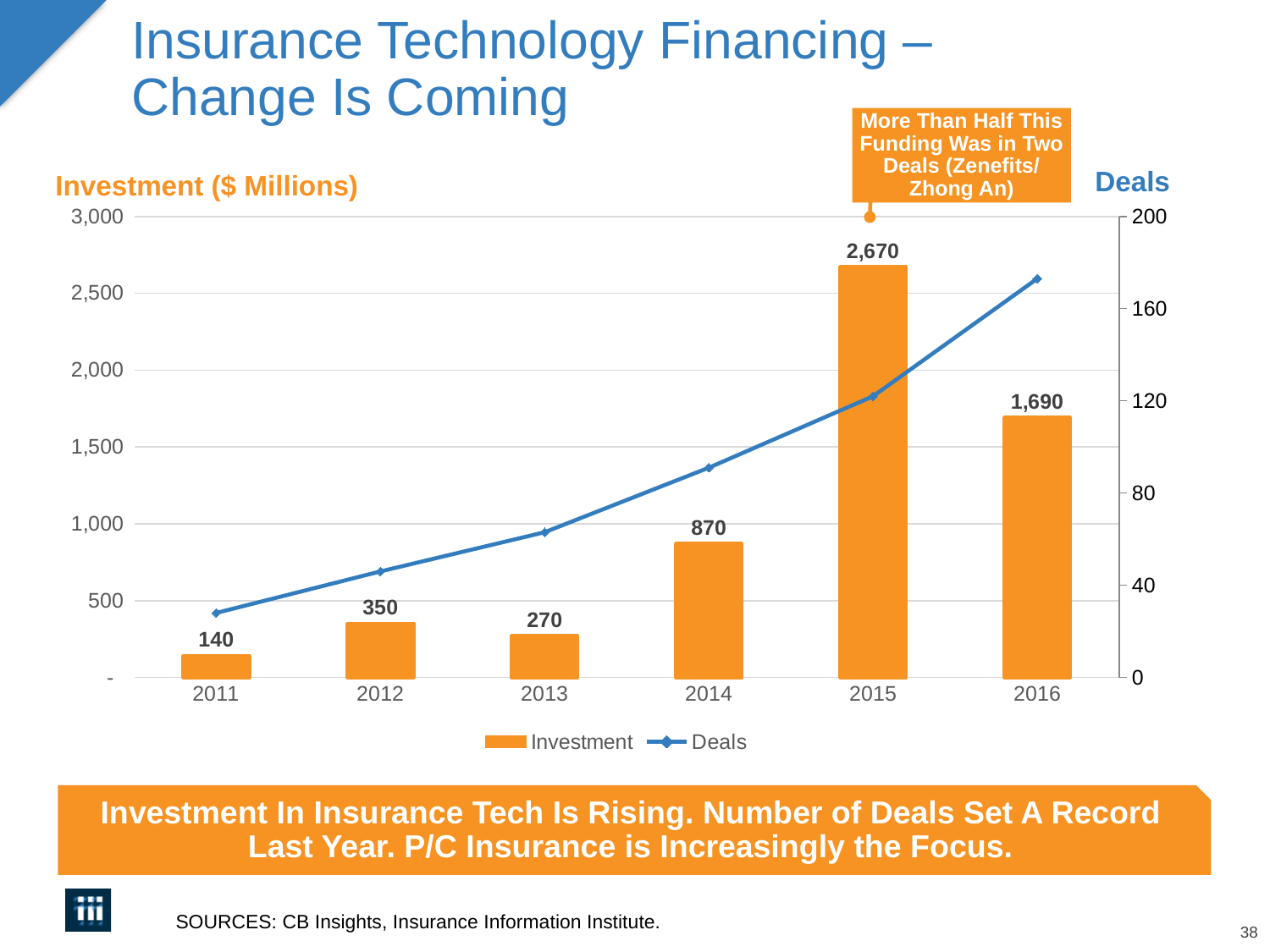
Which year had the lowest investment? 2011 How many series does the legend list? 2 Which year had a larger investment, 2012 or 2013? 2012 Is the number of deals in 2011 greater or less than 40? less What was the investment in 2016? 1,690 What was the investment in 2011? 140 Which year had the highest investment? 2015 Does the number of deals rise or fall from 2011 to 2016? rise What is the difference between the investment in 2015 and the investment in 2016? 980 Is the number of deals in 2016 greater or less than 160? greater How many years are shown on the x axis? 6 What was the investment in 2015? 2,670